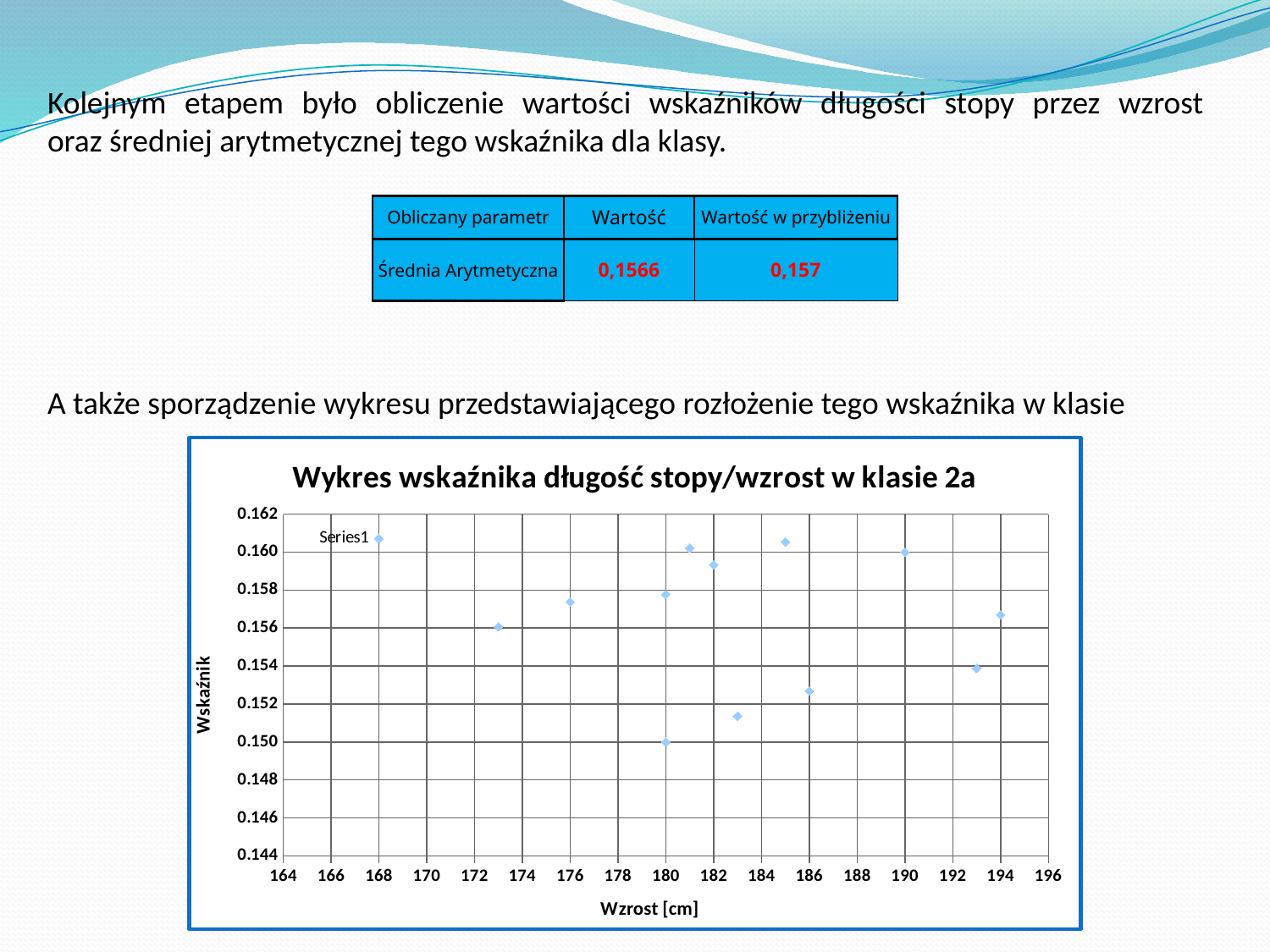
Is the lowest value plotted at height 180 greater or less than 0.152? less What kind of chart is shown on the slide? scatter chart Is the value plotted at height 176 greater or less than 0.156? greater Is the value plotted at height 186 greater or less than 0.154? less What is the label of the x axis of the chart? Wzrost [cm] At which height (Wzrost) is the lowest Wskaźnik value plotted? 180 Which has the larger Wskaźnik value: the point at height 181 or the point at height 183? 181 What is the title of the chart? Wykres wskaźnika długość stopy/wzrost w klasie 2a Which has the larger Wskaźnik value: the point at height 186 or the point at height 194? 194